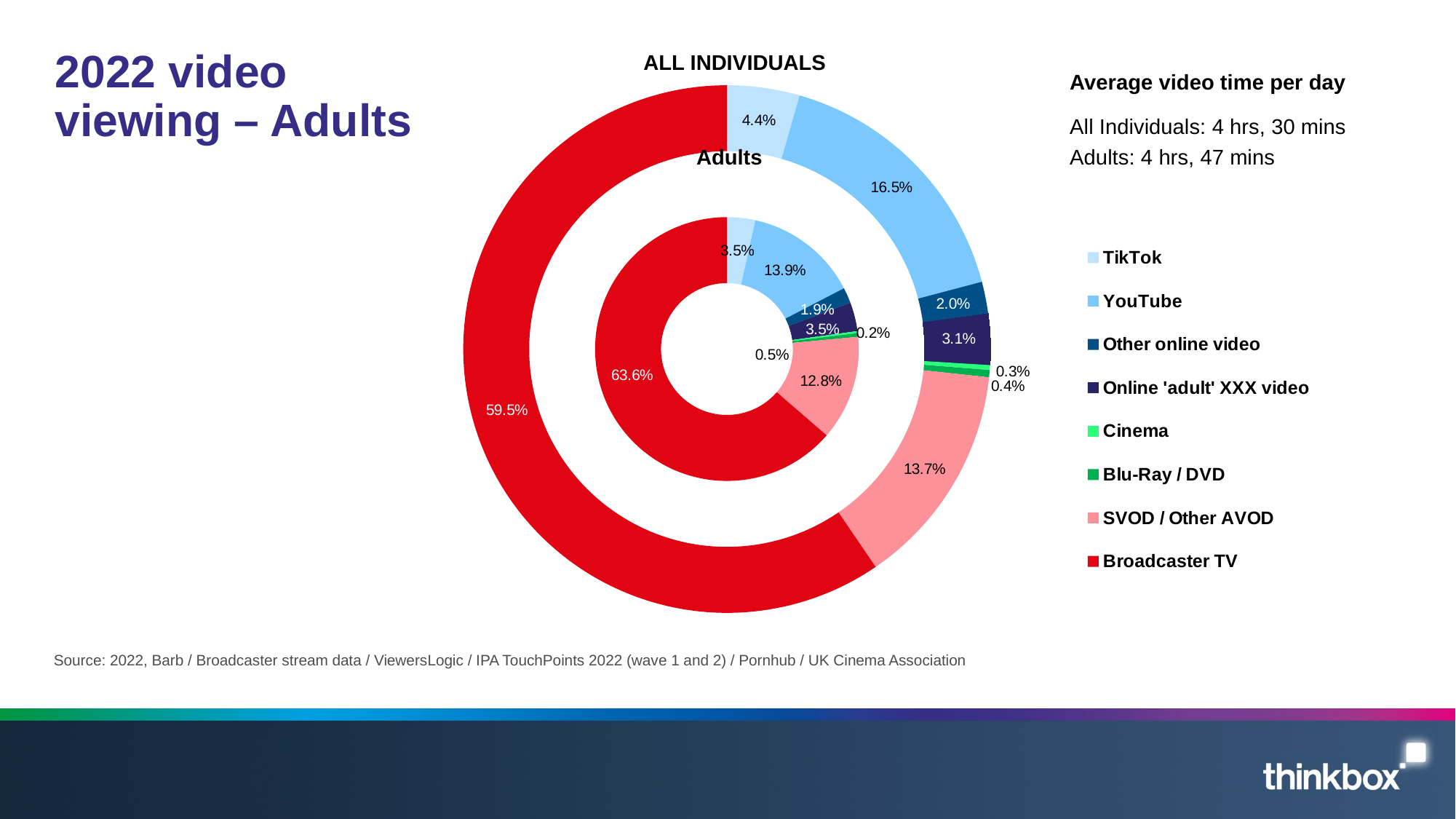
Which category has the smallest share in the All Individuals ring? Cinema What is the YouTube share for Adults? 13.9% Which is larger: the SVOD / Other AVOD share for All Individuals or for Adults? All Individuals What is the YouTube share for All Individuals? 16.5% What is the SVOD / Other AVOD share for Adults? 12.8% How much larger is the Broadcaster TV share for Adults than for All Individuals? 4.1 percentage points Which category has the largest share in the All Individuals ring? Broadcaster TV What kind of chart is shown on the slide? Doughnut chart In the outer ring (All Individuals), what share of video viewing is Broadcaster TV? 59.5% In the inner ring (Adults), what share of video viewing is Broadcaster TV? 63.6% How many categories does the legend list? 8 What is the TikTok share for All Individuals? 4.4%